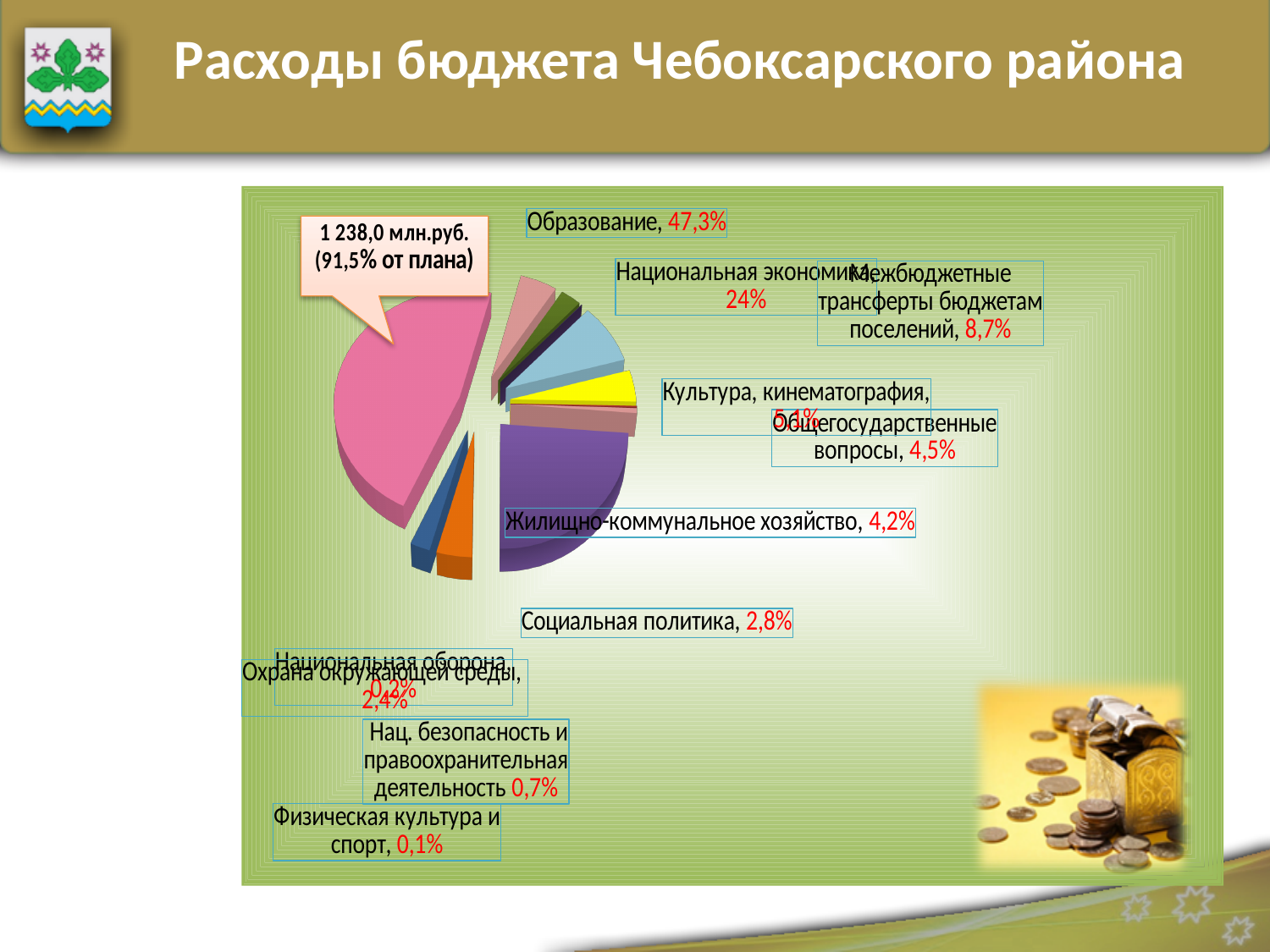
What is the value shown for Общегосударственные вопросы? 4,5% Which category has the largest share of the budget expenditures? Образование What is the value shown for Нац. безопасность и правоохранительная деятельность? 0,7% What is the value shown for Межбюджетные трансферты бюджетам поселений? 8,7% Which category has the smallest share, Физическая культура и спорт? Физическая культура и спорт, 0,1% What kind of chart is shown on the slide? pie chart What is the value shown for Жилищно-коммунальное хозяйство? 4,2% What is the value shown for Социальная политика? 2,8% By how many percentage points does Образование exceed Национальная экономика? 23,3 What is the value shown for Национальная экономика? 24% What share of expenditures goes to Образование? 47,3% What total amount of expenditures is shown in the callout next to the chart? 1 238,0 млн.руб. (91,5% от плана)